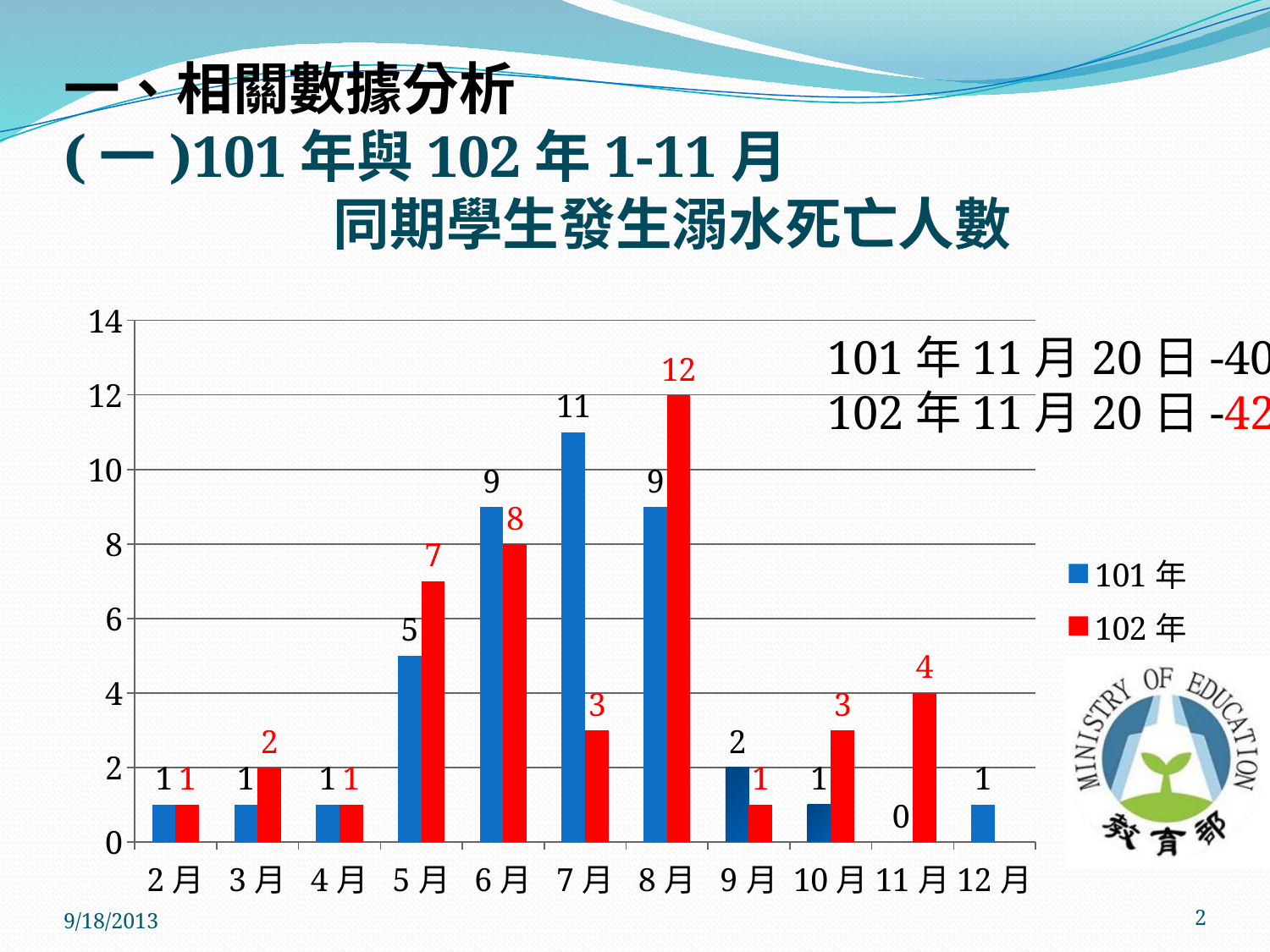
How many months are shown on the x axis? 11 In which month is the 102年 value highest? 8月 Which colour represents 102年 in the legend? red What kind of chart is shown on the slide? bar chart Which is larger in 6月, the 101年 value or the 102年 value? 101年 What is the value for 102年 in 5月? 7 What is the difference between the 101年 and 102年 values in 7月? 8 What is the value for 102年 in 8月? 12 In which month is the 101年 value highest? 7月 How many series does the legend list? 2 What is the value for 101年 in 7月? 11 What is the value for 101年 in 11月? 0